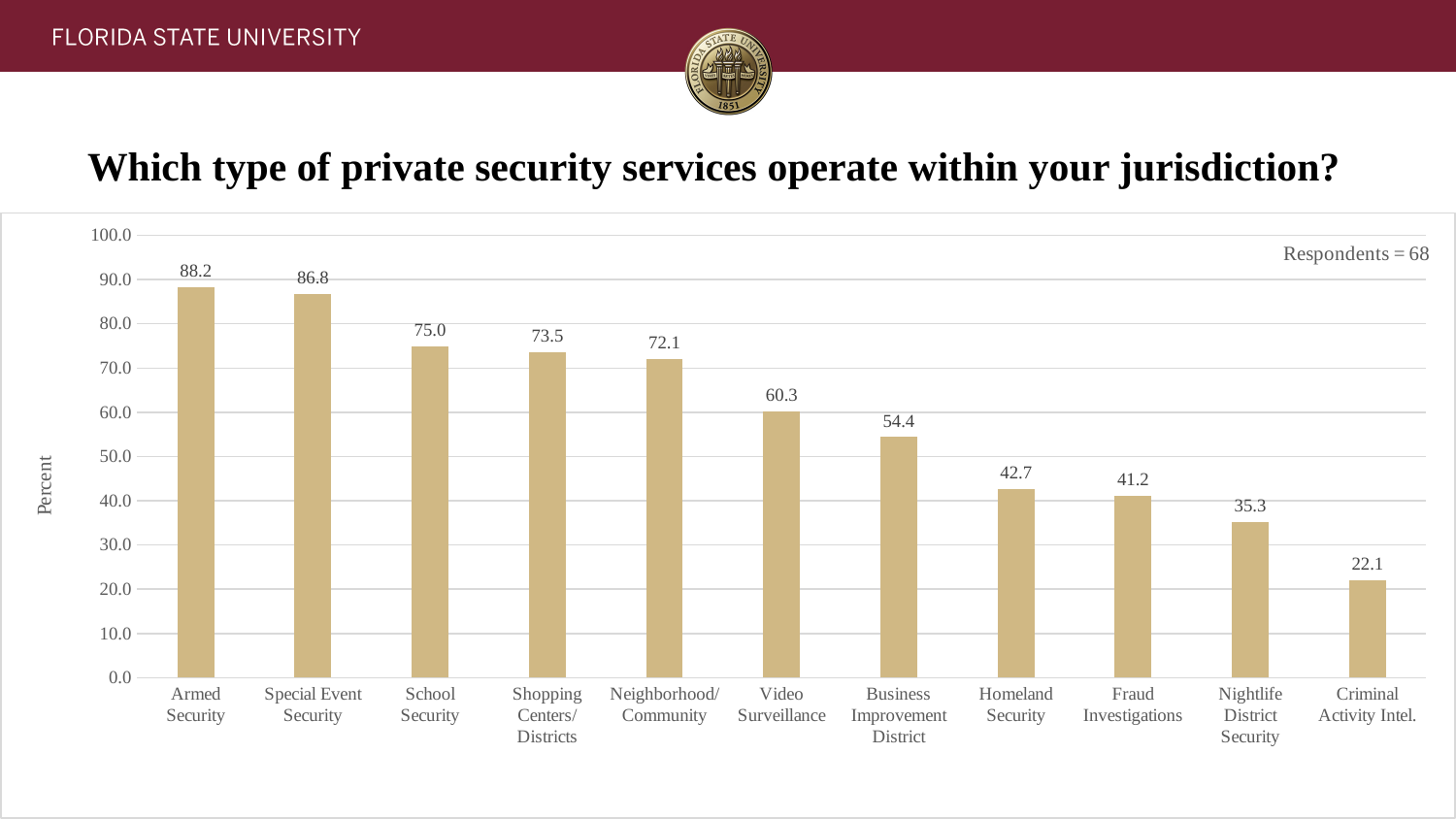
What is the value for Nightlife District Security? 35.3 Do the values rise or fall from left to right along the x axis? Fall What is the value for Video Surveillance? 60.3 What kind of chart is shown on the slide? Bar chart What is the difference between the values for Armed Security and Criminal Activity Intel.? 66.1 What is the value for Armed Security? 88.2 Which is larger, the value for Business Improvement District or the value for Homeland Security? Business Improvement District Which category has the lowest value? Criminal Activity Intel. How many categories are shown on the x axis? 11 Which category has the highest value? Armed Security How many respondents does the chart note? 68 What is the difference between the values for School Security and Shopping Centers/Districts? 1.5